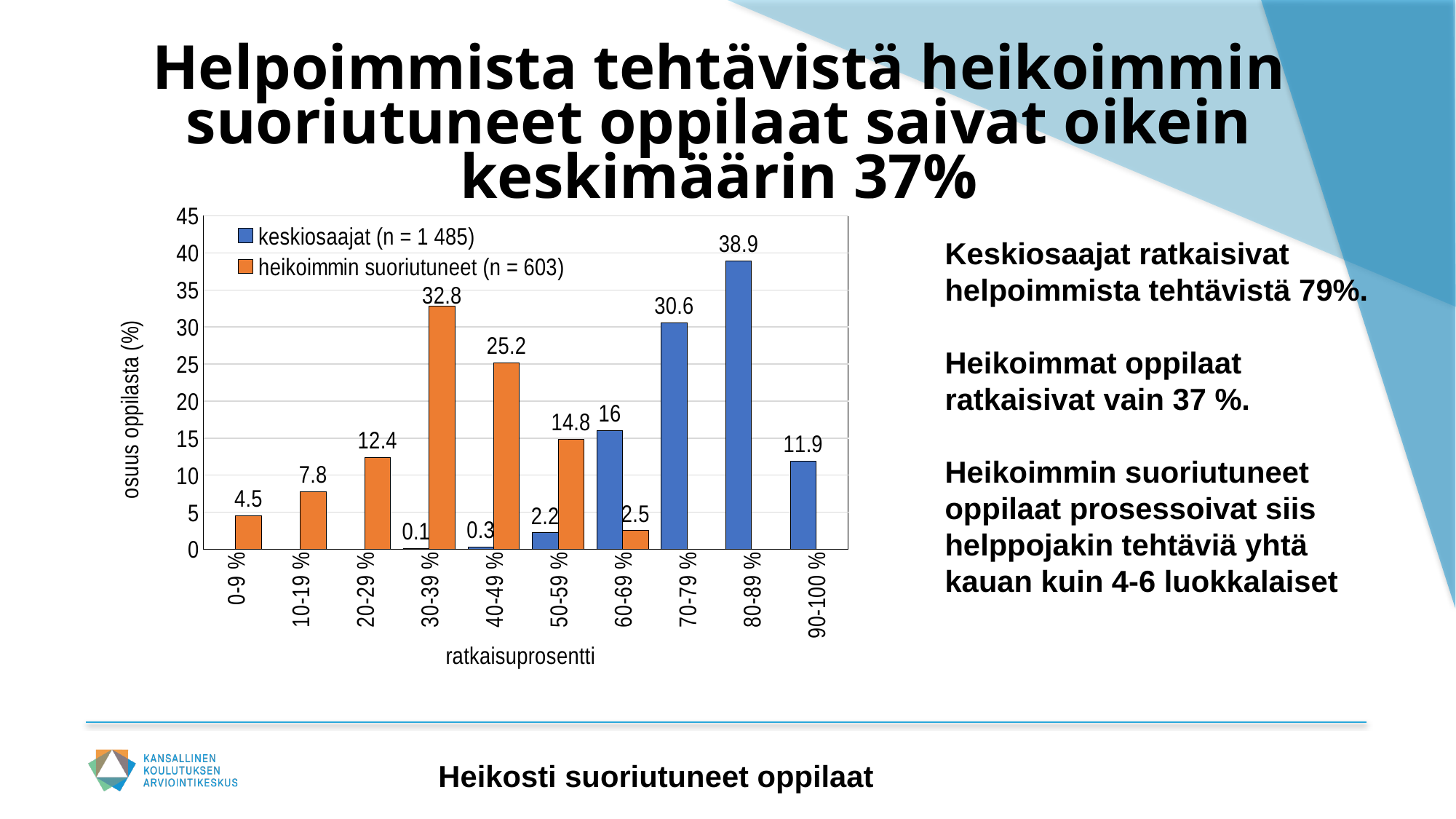
How many series does the chart legend list? 2 What is the difference between the keskiosaajat value in the 80-89 % category and the 70-79 % category? 8.3 What is the sample size (n) given in the legend for heikoimmin suoriutuneet? 603 What is the value for heikoimmin suoriutuneet in the 30-39 % category? 32.8 Which category has the highest value for keskiosaajat? 80-89 % How many categories are shown on the x axis of the chart? 10 What is the value for keskiosaajat in the 80-89 % category? 38.9 What is the value for keskiosaajat in the 60-69 % category? 16 Which category has the highest value for heikoimmin suoriutuneet? 30-39 % What is the label of the y axis of the chart? osuus oppilasta (%) What type of chart is shown on the slide? bar chart In the 50-59 % category, which series has the larger value, keskiosaajat or heikoimmin suoriutuneet? heikoimmin suoriutuneet